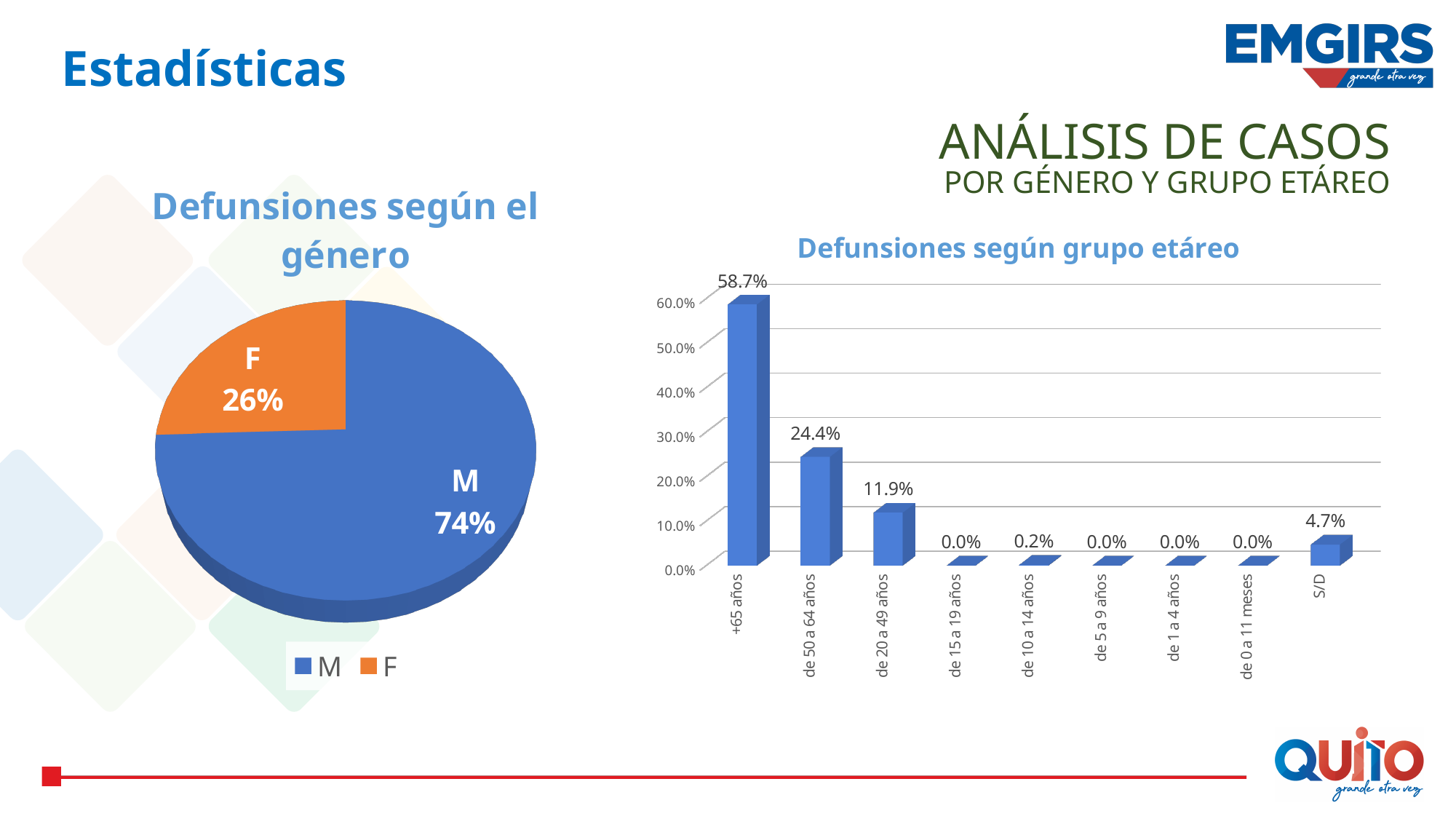
In the 'Defunsiones según el género' chart, what share of deaths is F? 26% What kind of chart is 'Defunsiones según grupo etáreo'? Bar chart In the 'Defunsiones según grupo etáreo' chart, what is the difference between +65 años and de 50 a 64 años? 34.3% In the 'Defunsiones según grupo etáreo' chart, what is the value for +65 años? 58.7% What kind of chart is 'Defunsiones según el género'? Pie chart In the 'Defunsiones según el género' chart, what share of deaths is M? 74% In the 'Defunsiones según grupo etáreo' chart, which age group has the highest value? +65 años In the 'Defunsiones según grupo etáreo' chart, what is the value for S/D? 4.7% How many entries does the legend of the 'Defunsiones según el género' chart list? 2 In the 'Defunsiones según grupo etáreo' chart, which is larger, de 20 a 49 años or S/D? de 20 a 49 años In the 'Defunsiones según grupo etáreo' chart, what is the value for de 50 a 64 años? 24.4% How many categories are shown on the x axis of the 'Defunsiones según grupo etáreo' chart? 9